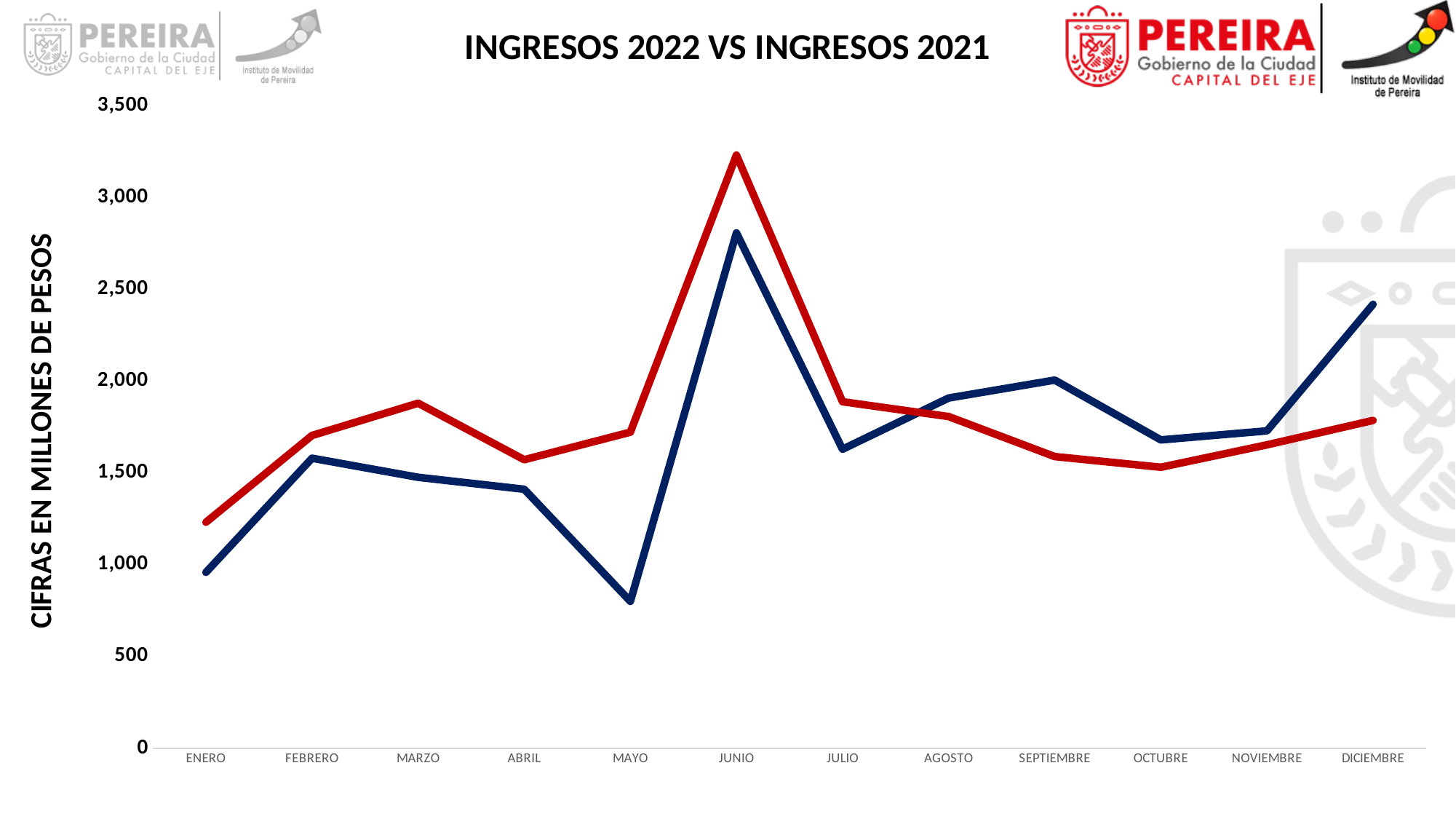
What is the title of the chart? INGRESOS 2022 VS INGRESOS 2021 In which month does the blue line reach its highest value? JUNIO In which month does the red line reach its highest value? JUNIO Is the value of the blue line in DICIEMBRE greater or less than 2,000? greater In DICIEMBRE, which line has the higher value, the red line or the blue line? the blue line In which month does the red line reach its lowest value? ENERO Is the value of the blue line in MAYO greater or less than 1,000? less Is the value of the red line in JUNIO greater or less than 3,000? greater In JUNIO, which line has the higher value, the red line or the blue line? the red line What kind of chart is shown on the slide? line chart In which month does the blue line reach its lowest value? MAYO How many months are shown along the x axis of the chart? 12